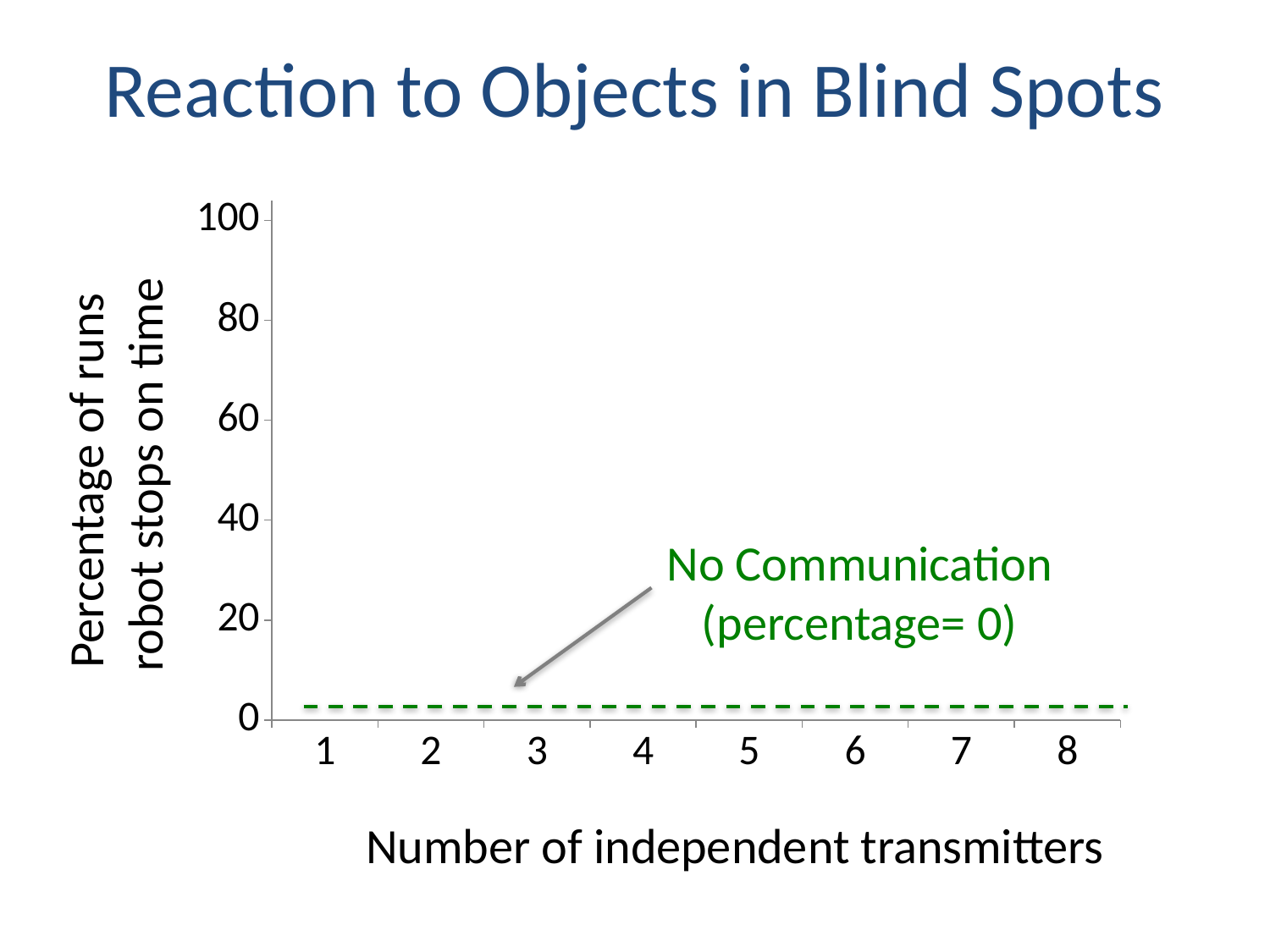
What percentage is given for the No Communication line? 0 How many values for the number of independent transmitters are shown on the x axis? 8 What is the label of the x axis? Number of independent transmitters Does the No Communication line rise, fall, or stay flat as the number of independent transmitters increases? stays flat What is the highest value shown on the y axis? 100 What is the title of the chart? Reaction to Objects in Blind Spots Is the value of the No Communication line at 4 transmitters greater or less than 20? less Is the value of the No Communication line at 8 transmitters greater or less than 40? less What kind of chart is shown on the slide? line chart